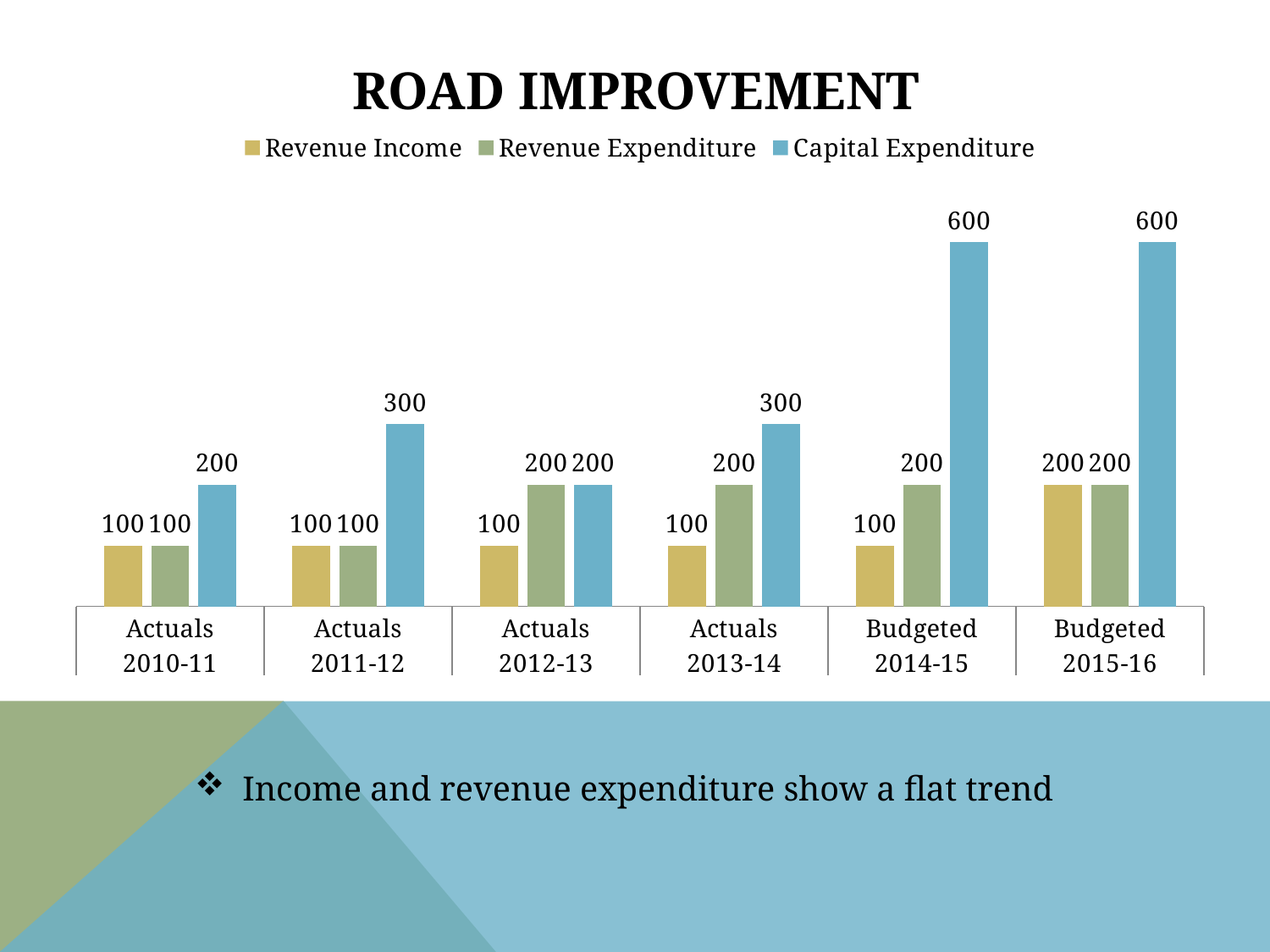
How many categories are shown on the x axis? 6 What is the Revenue Income value for Budgeted 2015-16? 200 What is the Capital Expenditure value for Budgeted 2014-15? 600 Does Capital Expenditure rise or fall from Actuals 2013-14 to Budgeted 2014-15? Rise Which category has the lowest Capital Expenditure value? Actuals 2010-11 and Actuals 2012-13 (both 200) What is the Capital Expenditure value for Actuals 2011-12? 300 How many series does the legend list? 3 Which is larger: Revenue Expenditure for Actuals 2011-12 or Revenue Expenditure for Actuals 2013-14? Actuals 2013-14 What is the difference between Capital Expenditure for Budgeted 2014-15 and Actuals 2013-14? 300 What is the title of the chart? ROAD IMPROVEMENT What kind of chart is shown on the slide? Bar chart What is the Revenue Expenditure value for Actuals 2012-13? 200